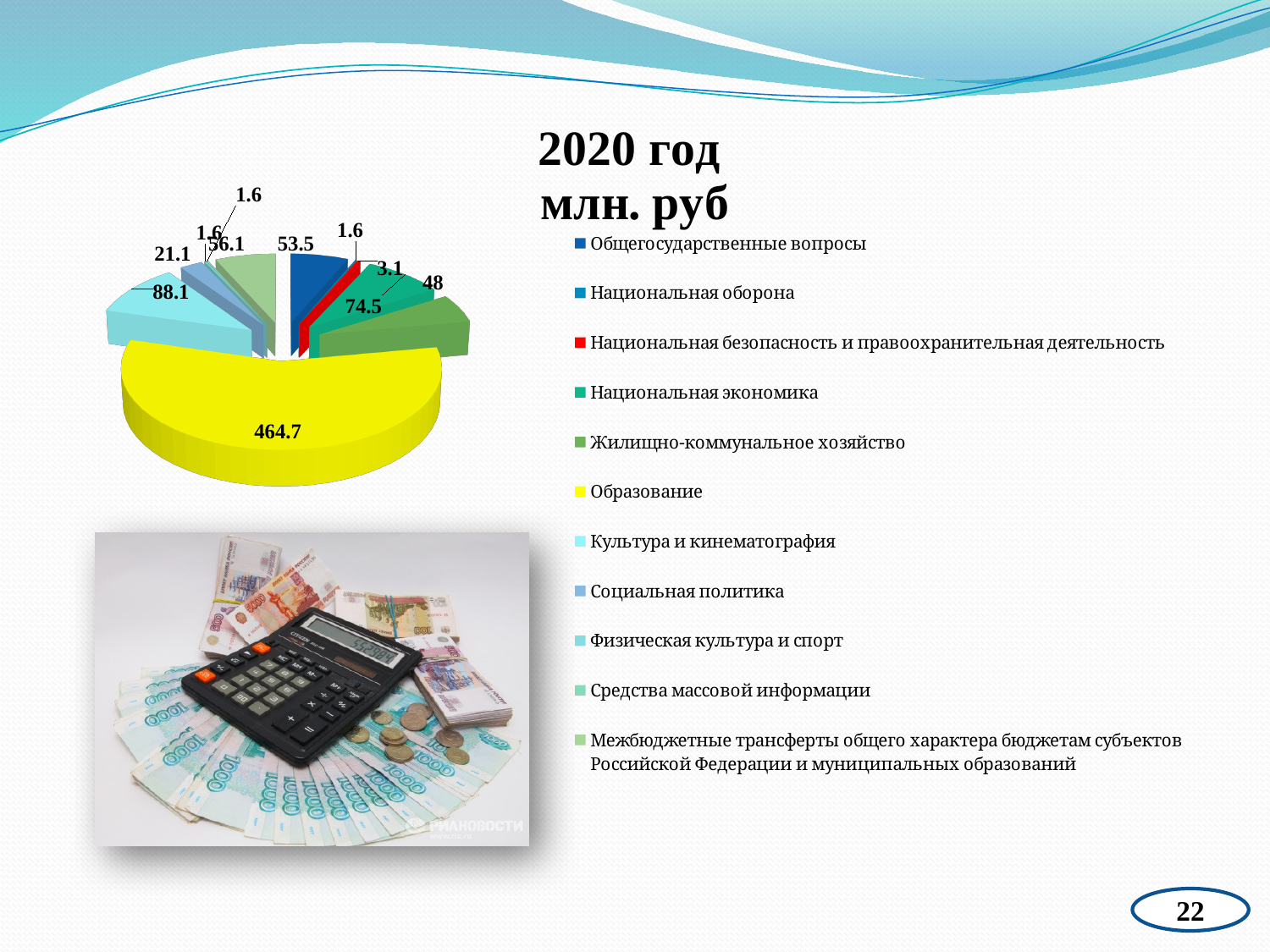
What is the value for Национальная безопасность и правоохранительная деятельность? 3.1 Which is larger, the value for Образование or the value for Культура и кинематография? Образование What is the title of the chart? 2020 год млн. руб What is the difference between the value for Образование and the value for Культура и кинематография? 376.6 Which category has the largest slice of the pie? Образование What is the value for Общегосударственные вопросы? 53.5 What is the value for Образование? 464.7 What is the value for Культура и кинематография? 88.1 Which is larger, the value for Общегосударственные вопросы or the value for Национальная безопасность и правоохранительная деятельность? Общегосударственные вопросы What colour is the slice for Образование? yellow What kind of chart is shown on the slide? pie chart How many categories does the legend list? 11